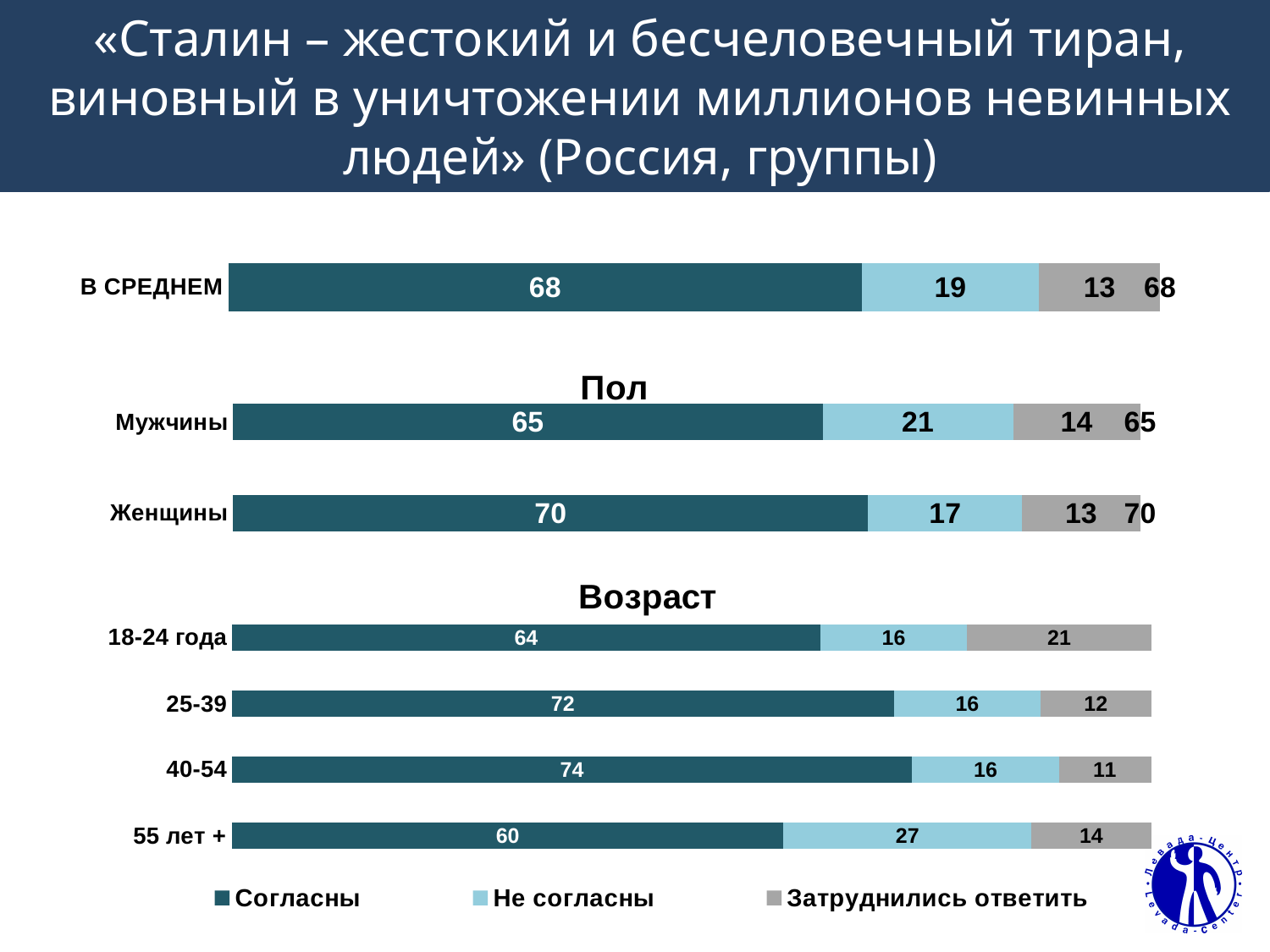
Which legend entry is shown in the dark teal colour? Согласны In the 'В СРЕДНЕМ' chart at the top, what is the value for 'Затруднились ответить'? 13 In the 'Пол' chart, what is the difference between the 'Согласны' values for Женщины and Мужчины? 5 In the 'Возраст' chart, which has the larger 'Затруднились ответить' value: '18-24 года' or '25-39'? 18-24 года In the 'Возраст' chart, which age group has the highest value for 'Согласны'? 40-54 In the 'Возраст' chart, what is the total of the stacked bar for the '25-39' group? 100 What kind of chart is the 'Пол' chart? Stacked bar chart How many series does the legend at the bottom of the slide list? 3 In the 'Возраст' chart, how many age groups are shown? 4 In the 'Возраст' chart, what is the value for 'Не согласны' for the '55 лет +' group? 27 In the 'Пол' chart, what is the value for 'Согласны' for Женщины? 70 In the 'Возраст' chart, which age group has the lowest value for 'Согласны'? 55 лет +